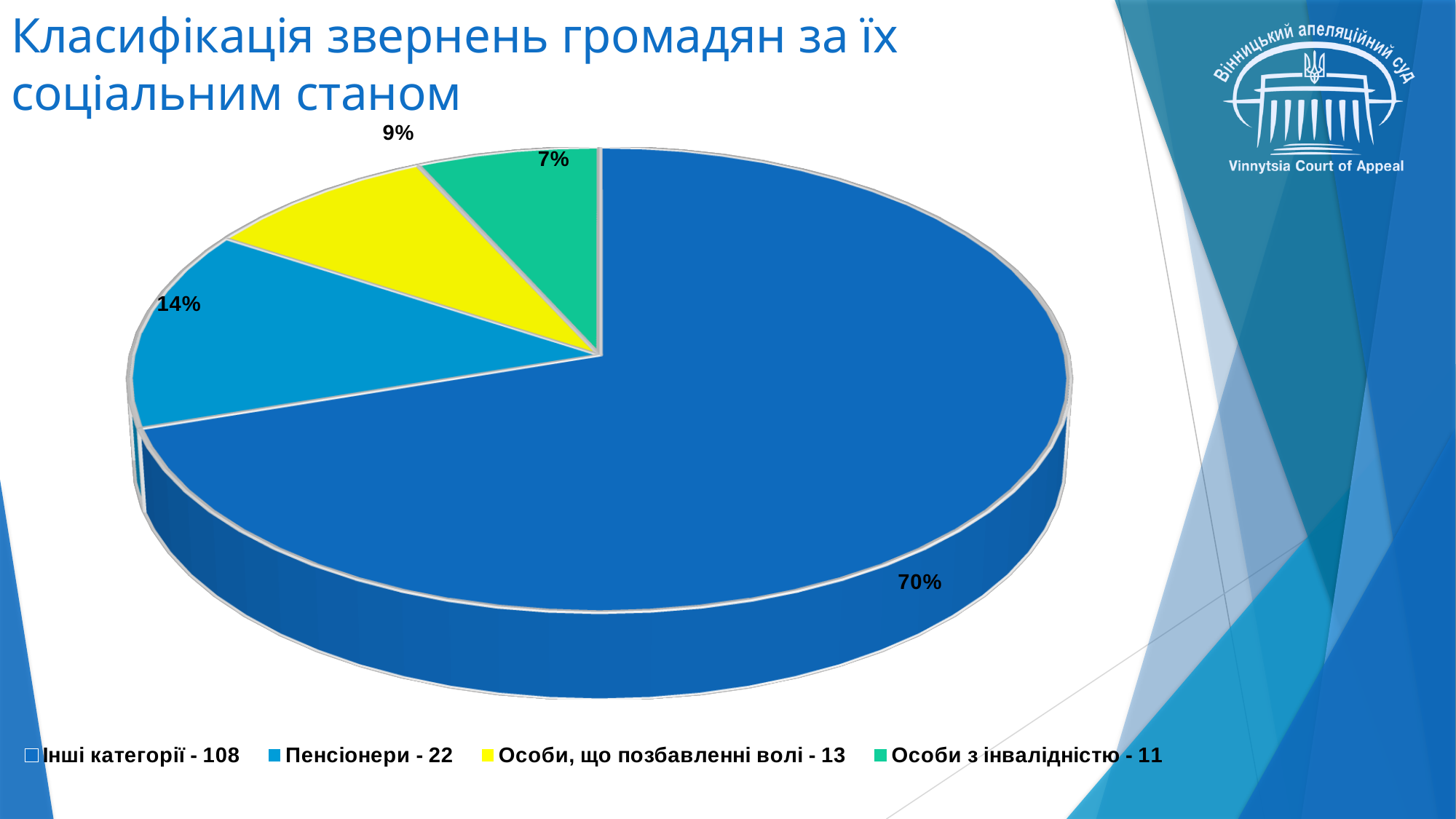
What percentage share does the slice for "Інші категорії" have? 70% Which slice is larger: "Пенсіонери" or "Особи, що позбавленні волі"? Пенсіонери What percentage share does the slice for "Пенсіонери" have? 14% How many slices does the pie chart have? 4 What is the difference in percentage points between the "Пенсіонери" slice and the "Особи з інвалідністю" slice? 7% What kind of chart is shown on the slide? pie chart Which category has the largest slice of the pie? Інші категорії Which category has the smallest slice of the pie? Особи з інвалідністю According to the legend, how many appeals are in the "Пенсіонери" category? 22 What percentage share does the slice for "Особи, що позбавленні волі" have? 9% What colour is the slice for "Особи, що позбавленні волі"? yellow